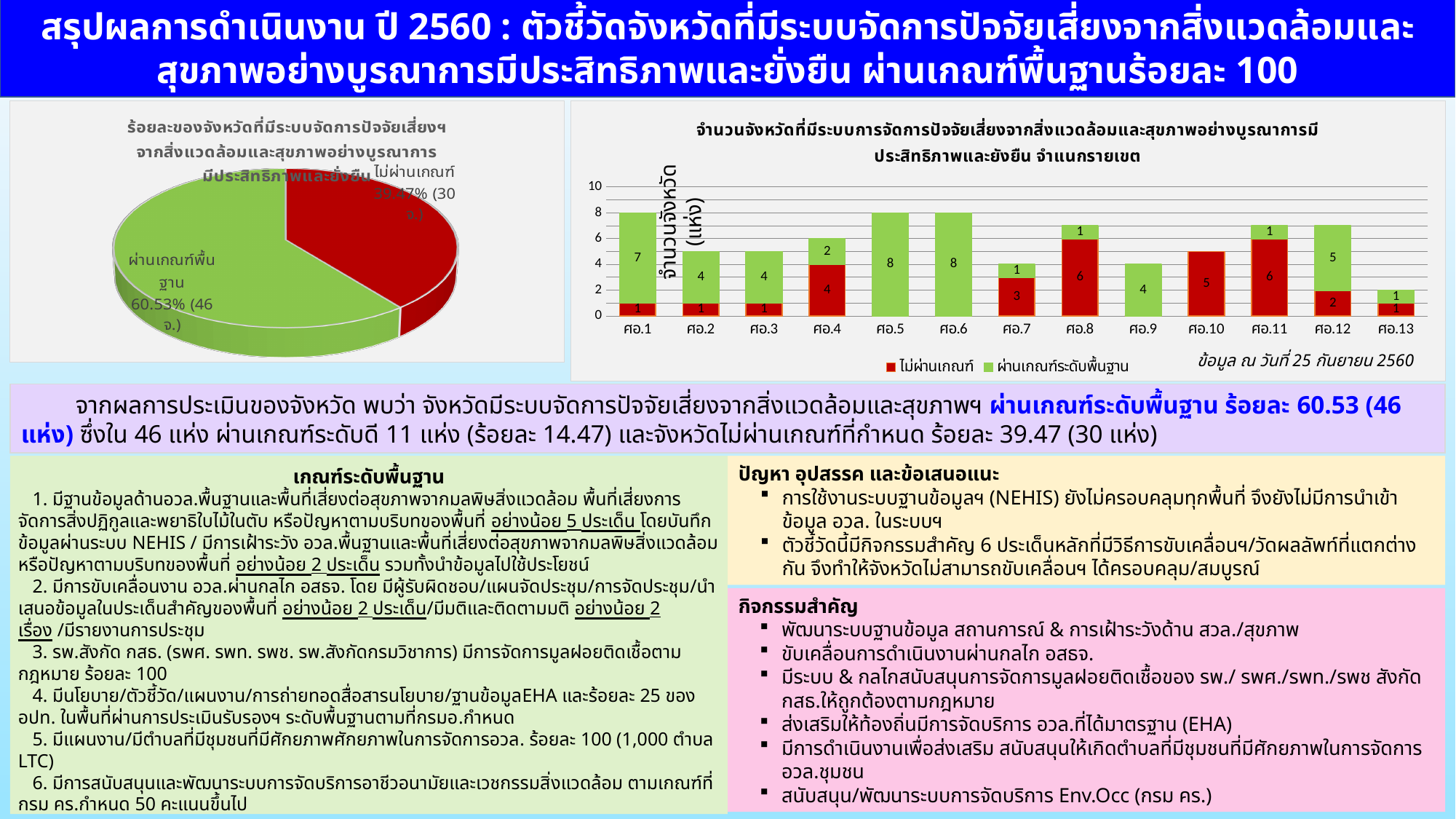
What kind of chart is the chart on the right of the slide? Bar chart On the right bar chart, how many series does the legend list? 2 On the left pie chart, how many provinces are in the ไม่ผ่านเกณฑ์ slice? 30 On the right bar chart, which category has the lowest total bar? ศอ.13 On the left pie chart, what share of provinces passed the basic criteria (ผ่านเกณฑ์พื้นฐาน)? 60.53% On the right bar chart, how many categories (ศอ.) are shown on the x axis? 13 On the left pie chart, what share of provinces did not pass the criteria (ไม่ผ่านเกณฑ์)? 39.47% On the right bar chart, what is the value of ไม่ผ่านเกณฑ์ for ศอ.8? 6 On the right bar chart, what is the total height of the stacked bar for ศอ.12? 7 On the right bar chart, what is the difference between the ไม่ผ่านเกณฑ์ values for ศอ.10 and ศอ.7? 2 On the right bar chart, what is the value of ผ่านเกณฑ์ระดับพื้นฐาน for ศอ.1? 7 What kind of chart is the chart on the left of the slide? Pie chart